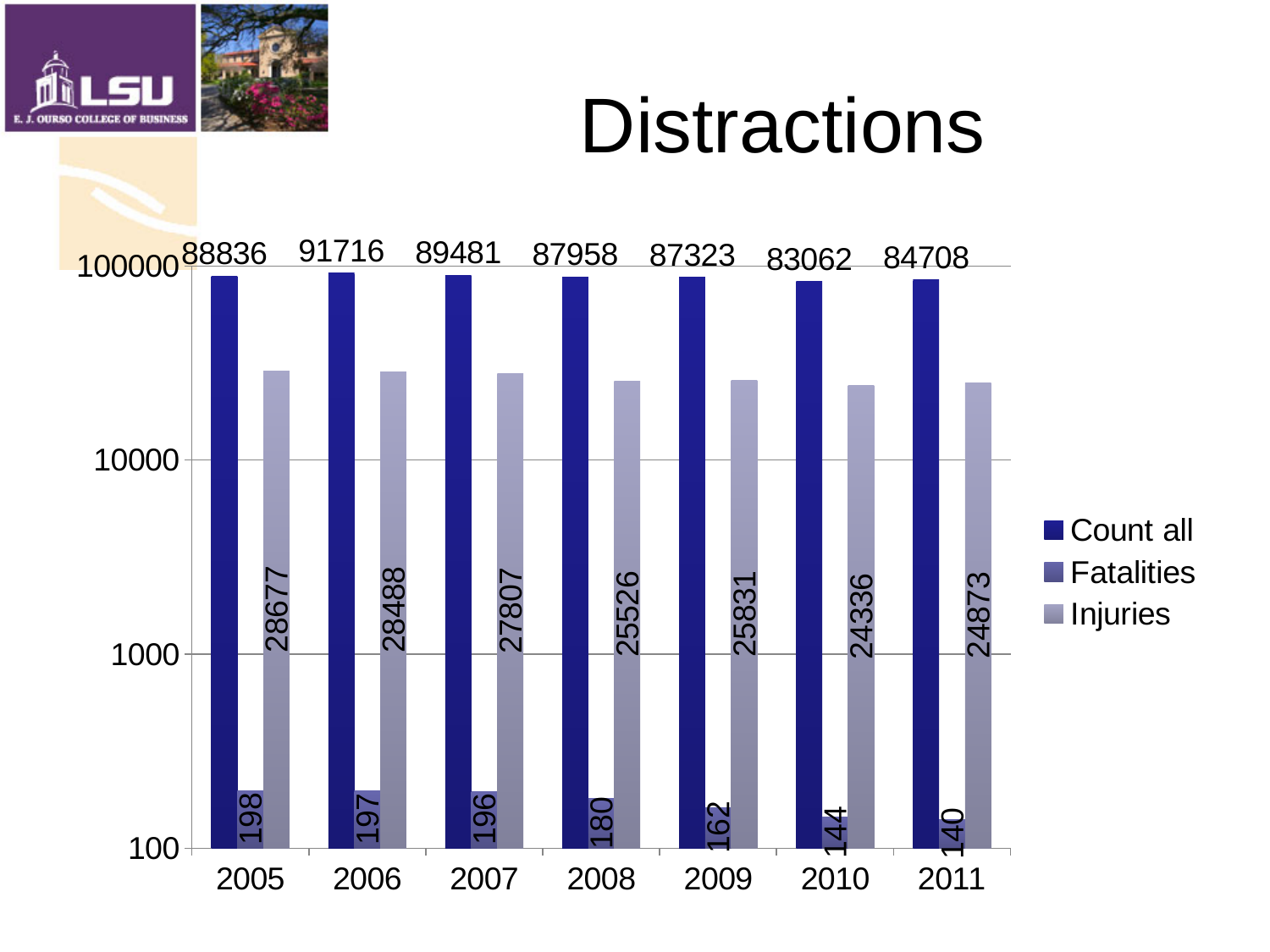
What kind of chart is shown on the slide? bar chart Which is larger, the Injuries value for 2009 or for 2008? 2009 What is the difference between the Fatalities values for 2005 and 2011? 58 What is the Count all value for 2006? 91716 Which year has the highest Count all value? 2006 What is the Fatalities value for 2008? 180 What is the title of the slide? Distractions How many years are shown on the x axis? 7 How many series does the legend list? 3 What is the Injuries value for 2010? 24336 Do the Fatalities values rise or fall from 2005 to 2011? fall Which year has the lowest Fatalities value? 2011